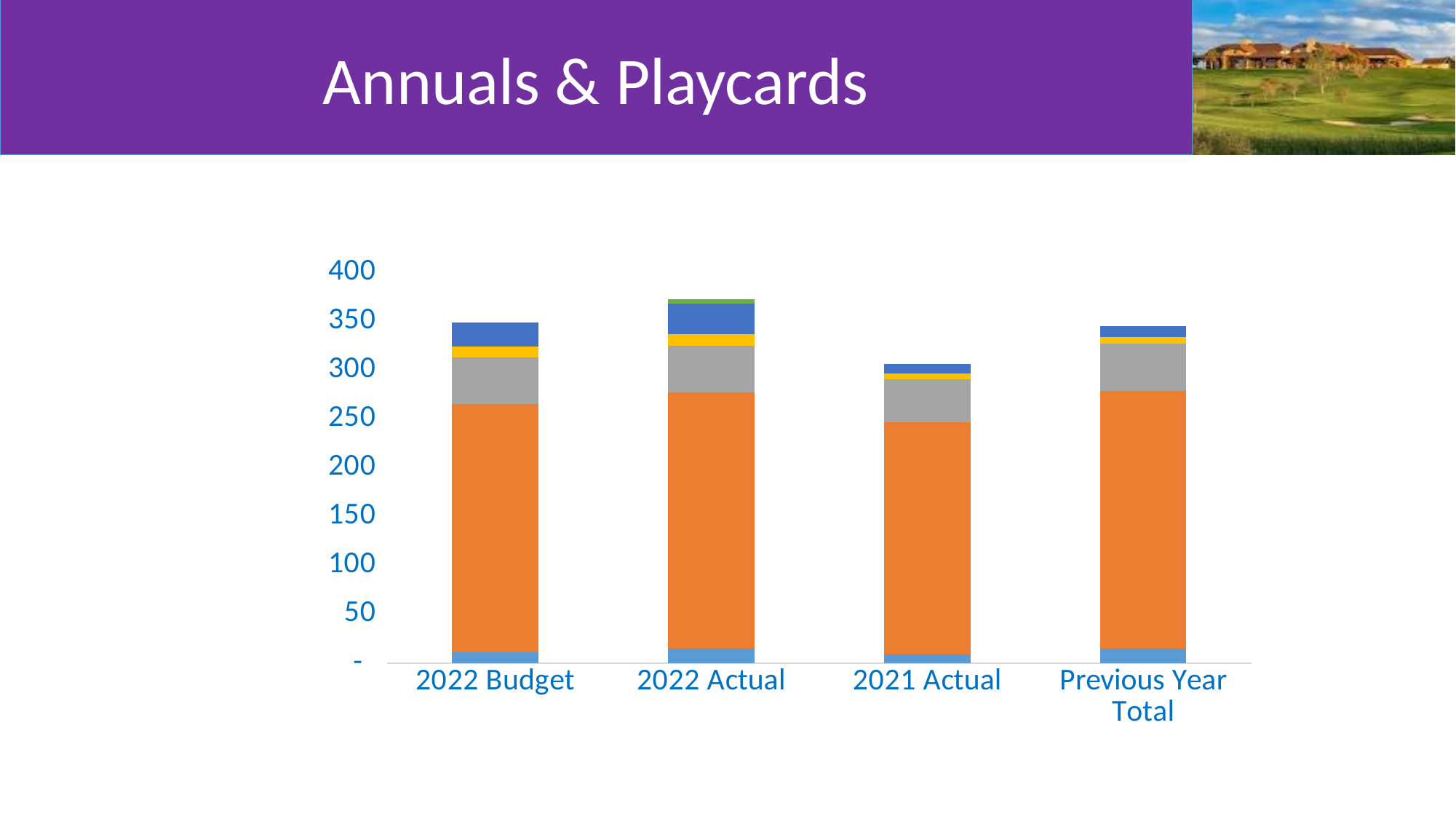
What kind of chart is shown on the slide? stacked bar chart Is the total height of the Previous Year Total bar greater or less than 300? greater Is the total height of the 2022 Actual bar greater or less than 350? greater Is the top of the orange segment in the 2022 Actual bar above or below 250 on the axis? above Which category has the shortest stacked bar overall? 2021 Actual How many categories are shown on the x axis of the chart? 4 What is the highest value labelled on the vertical axis of the chart? 400 What is the title of the slide containing the chart? Annuals & Playcards Which bar is taller overall, 2022 Actual or 2021 Actual? 2022 Actual Which category has the tallest stacked bar overall? 2022 Actual